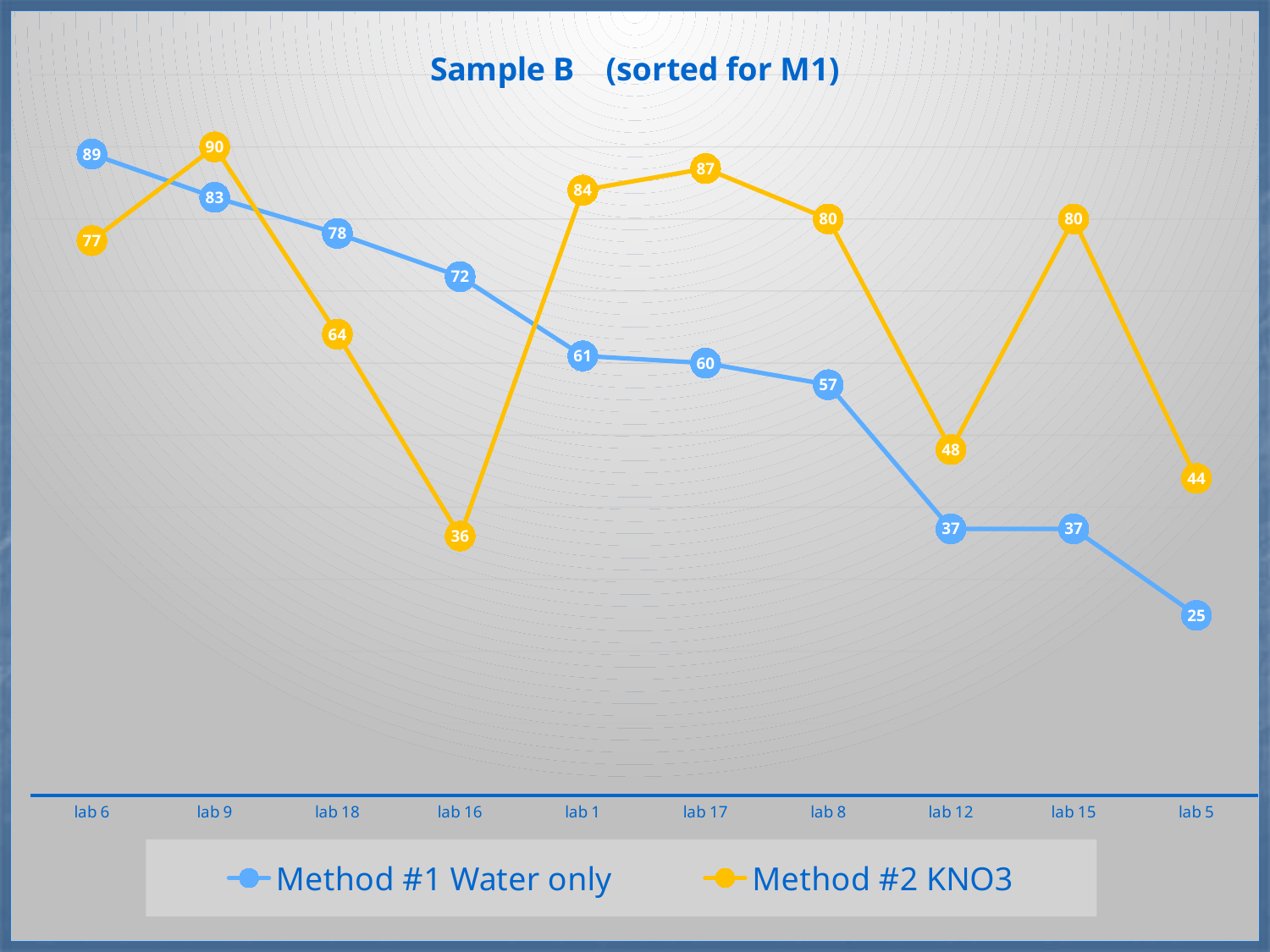
What is the value for Method #1 Water only at lab 16? 72 What is the difference between Method #2 KNO3 and Method #1 Water only at lab 15? 43 Which lab has the lowest value for Method #1 Water only? lab 5 What is the title of the chart? Sample B (sorted for M1) How many labs are shown on the x axis? 10 What kind of chart is shown on the slide? Line chart Do the values for Method #1 Water only rise or fall from lab 6 to lab 5? Fall How many series does the legend list? 2 What is the value for Method #2 KNO3 at lab 12? 48 Which lab has the highest value for Method #2 KNO3? lab 9 At lab 18, which method has the larger value? Method #1 Water only Which lab has the lowest value for Method #2 KNO3? lab 16